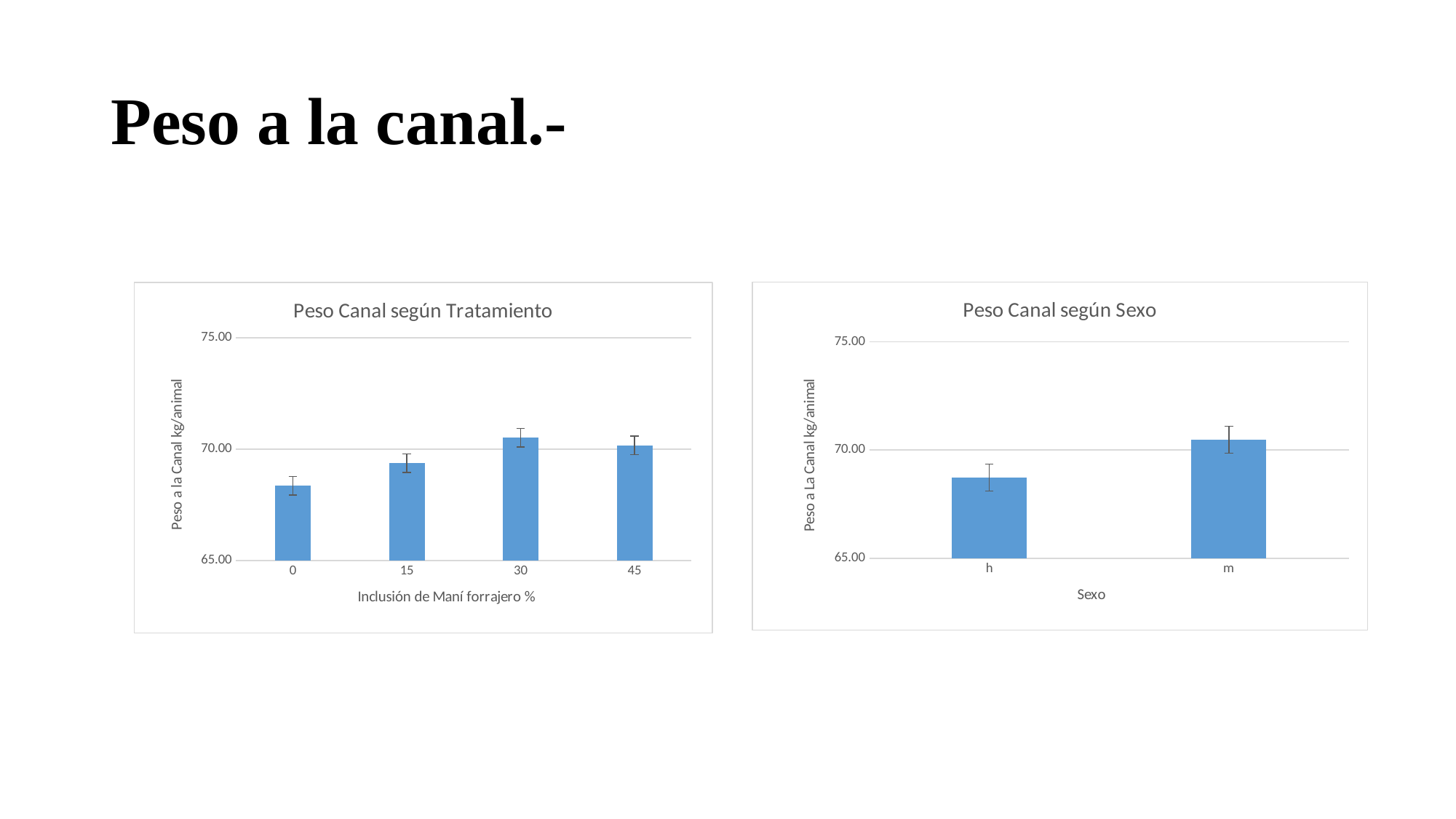
In the "Peso Canal según Sexo" chart, is the value for h greater or less than 70.00? less In the "Peso Canal según Tratamiento" chart, which inclusion level has the lowest carcass weight? 0 In the "Peso Canal según Sexo" chart, is the value for m greater or less than 70.00? greater In the "Peso Canal según Tratamiento" chart, is the value for 0 greater or less than 70.00? less In the "Peso Canal según Sexo" chart, which category has the higher carcass weight? m In the "Peso Canal según Tratamiento" chart, which bar is taller, 0 or 30? 30 How many bars does the "Peso Canal según Tratamiento" chart show? 4 What is the x-axis label of the "Peso Canal según Tratamiento" chart? Inclusión de Maní forrajero % What kind of chart is "Peso Canal según Tratamiento"? bar chart How many bars does the "Peso Canal según Sexo" chart show? 2 What is the title of the chart on the right side of the slide? Peso Canal según Sexo